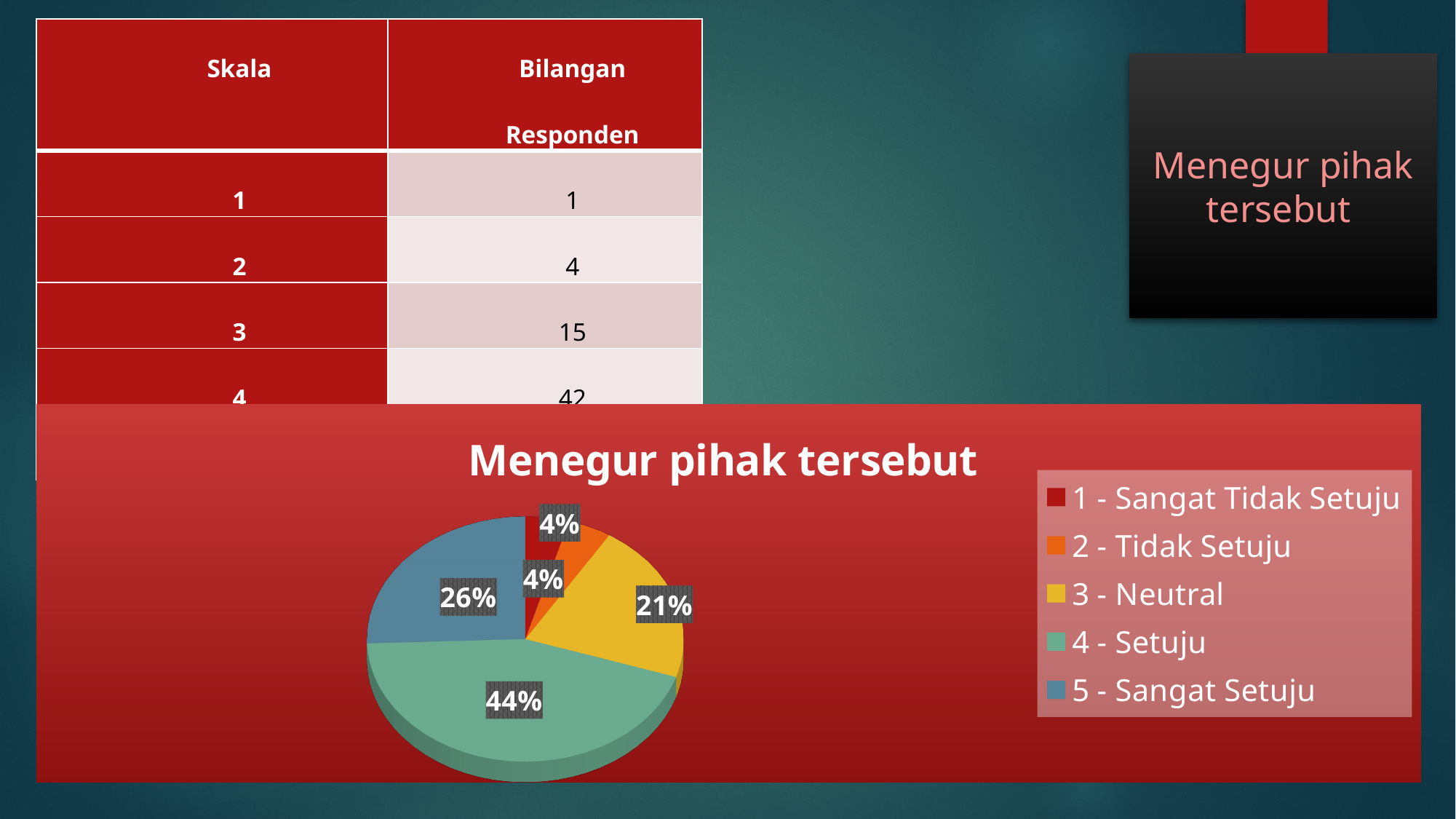
What share of the pie does '4 - Setuju' take? 44% What share of the pie does '3 - Neutral' take? 21% What kind of chart is shown on the slide? pie chart Which legend entry is shown in yellow? 3 - Neutral How many entries does the chart legend list? 5 Which category has the largest slice of the pie? 4 - Setuju How many slices does the pie chart have? 5 What share of the pie does '2 - Tidak Setuju' take? 4% Which is larger, the slice for '3 - Neutral' or the slice for '5 - Sangat Setuju'? 5 - Sangat Setuju What is the title of the chart? Menegur pihak tersebut What is the difference in percentage points between the '4 - Setuju' slice and the '5 - Sangat Setuju' slice? 18%